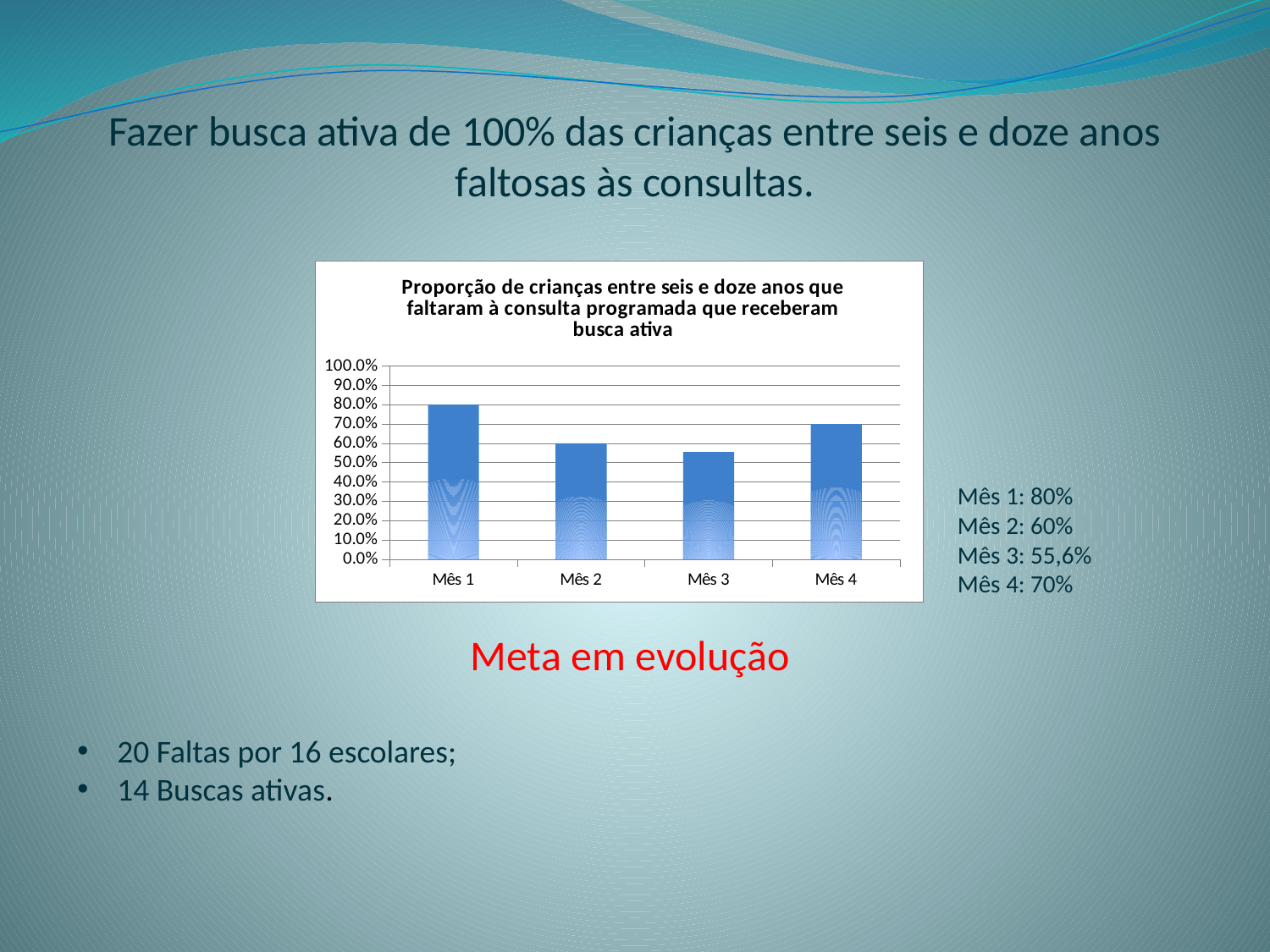
What is the value for Mês 4? 70% How many months (categories) are plotted in the chart? 4 What is the difference between the values for Mês 1 and Mês 2? 20% What is the value for Mês 3? 55,6% What is the value for Mês 1? 80% Which month has the highest value? Mês 1 What is the maximum value shown on the vertical axis of the chart? 100.0% What type of chart is shown on the slide? bar chart Which is larger, the value for Mês 2 or the value for Mês 4? Mês 4 Is the value for Mês 3 greater or less than 60%? less Which month has the lowest value? Mês 3 Does the value rise or fall from Mês 3 to Mês 4? rise